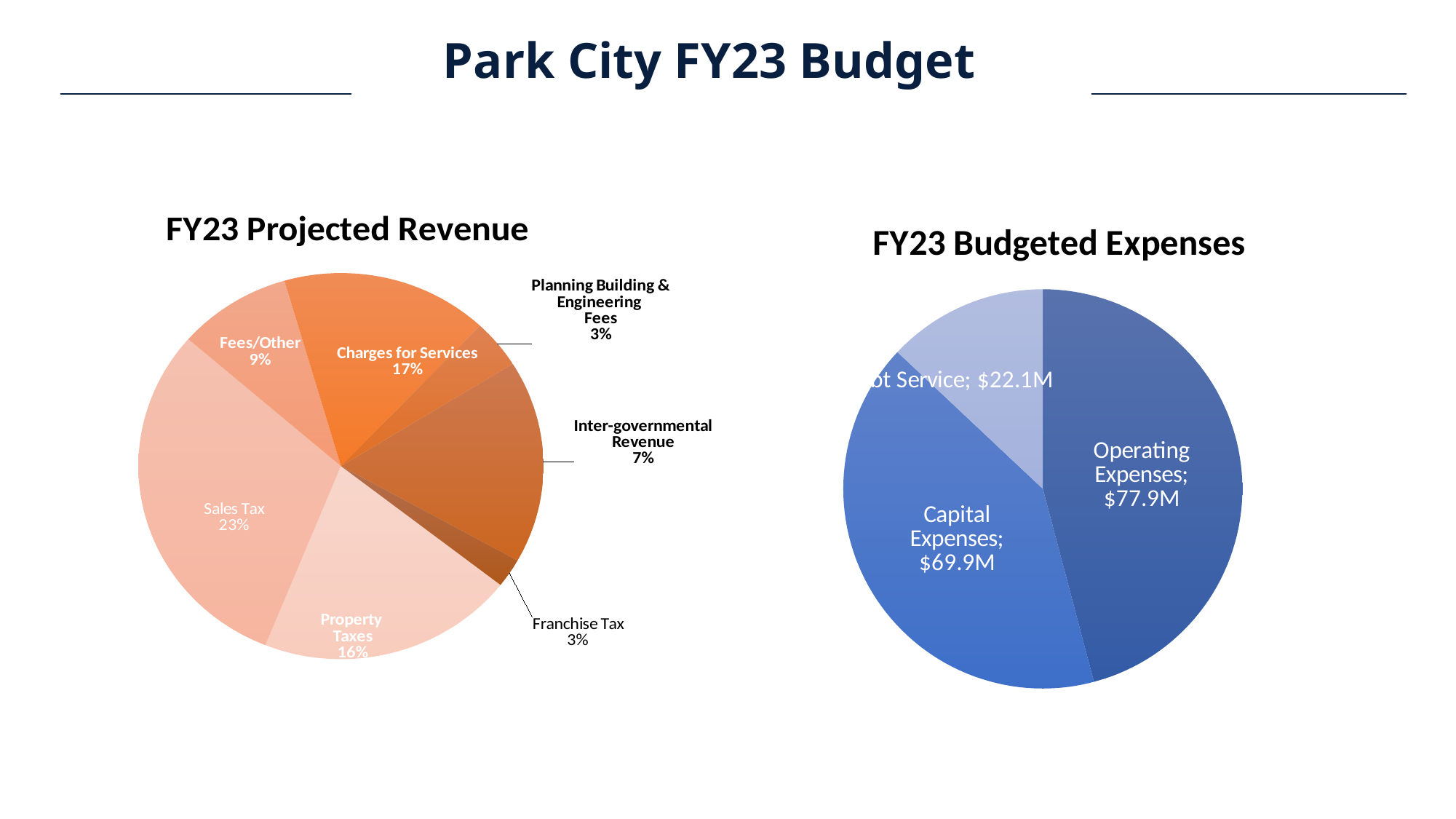
In the FY23 Projected Revenue chart, how many percentage points larger is Charges for Services than Fees/Other? 8% In the FY23 Projected Revenue chart, what percentage is Charges for Services? 17% In the FY23 Projected Revenue chart, which is larger, Sales Tax or Property Taxes? Sales Tax What kind of chart is the FY23 Budgeted Expenses chart? Pie chart In the FY23 Budgeted Expenses chart, what is the value for Capital Expenses? $69.9M In the FY23 Budgeted Expenses chart, which category is the largest? Operating Expenses In the FY23 Projected Revenue chart, what percentage is Property Taxes? 16% In the FY23 Projected Revenue chart, what percentage is Inter-governmental Revenue? 7% In the FY23 Budgeted Expenses chart, which category is the smallest? Debt Service In the FY23 Budgeted Expenses chart, what is the value for Operating Expenses? $77.9M In the FY23 Projected Revenue chart, what percentage is Sales Tax? 23% How many slices does the FY23 Budgeted Expenses chart have? 3